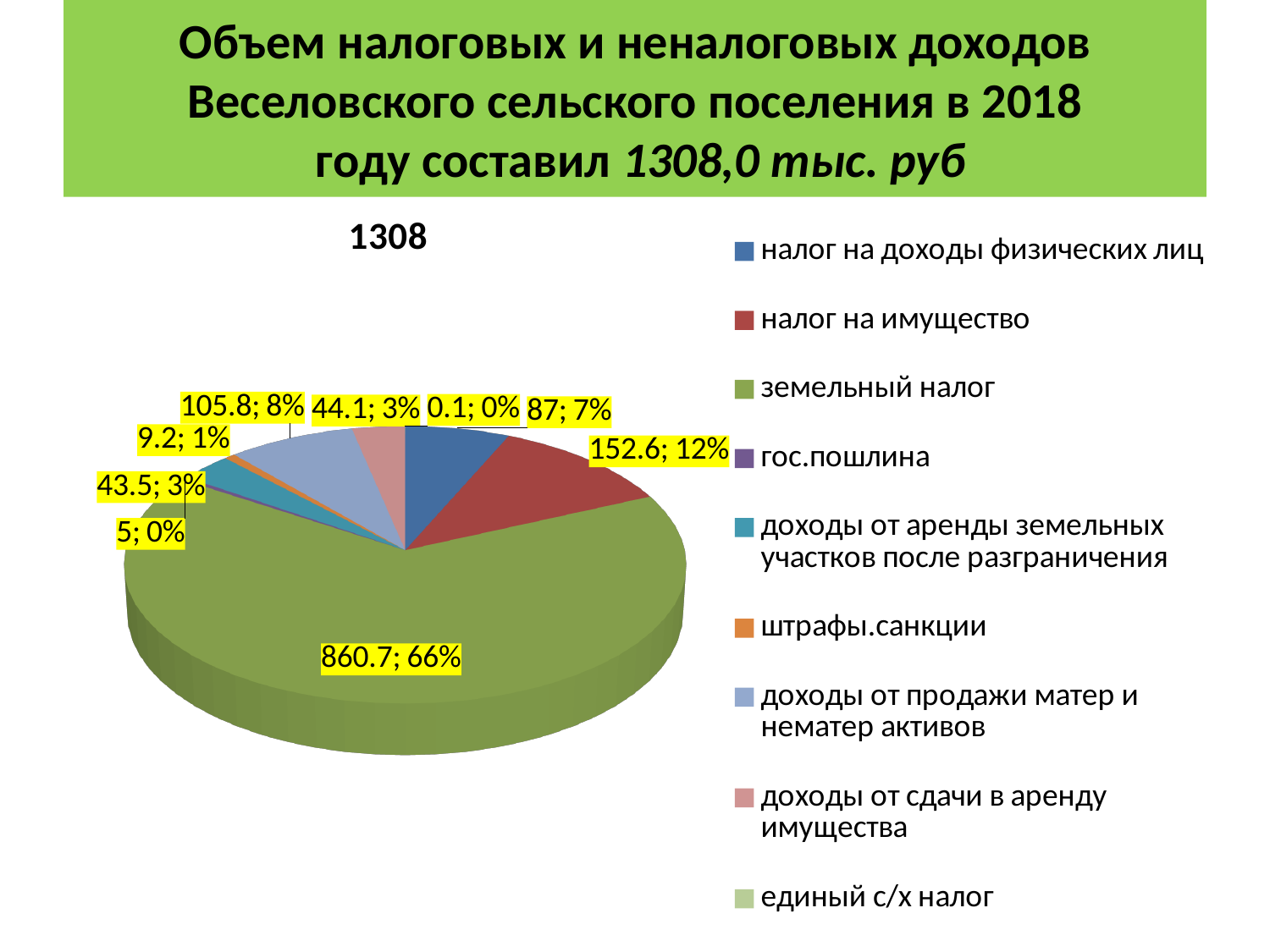
How many categories does the legend list? 9 What share of the pie does земельный налог represent? 66% Which is larger: доходы от продажи матер и нематер активов or налог на доходы физических лиц? доходы от продажи матер и нематер активов Which category has the smallest value? единый с/х налог Which category has the largest slice of the pie? земельный налог What is the value for налог на имущество? 152.6 What share of the pie does налог на доходы физических лиц represent? 7% What is the value for земельный налог? 860.7 What is the value for доходы от продажи матер и нематер активов? 105.8 What type of chart is shown on the slide? pie chart What is the title of the chart? 1308 What is the difference between the values for налог на имущество and налог на доходы физических лиц? 65.6